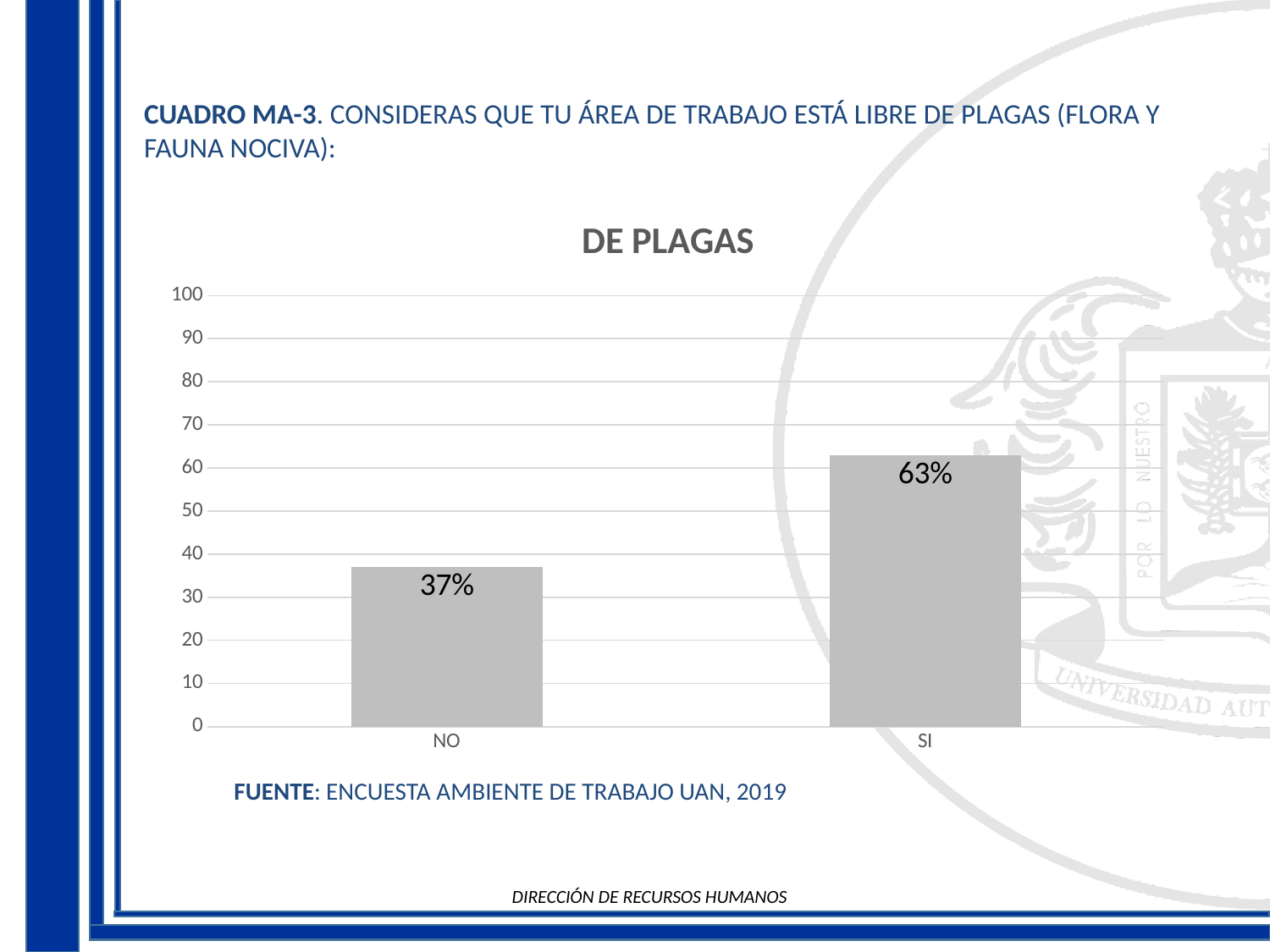
Is the value for NO greater or less than 40? less Which is larger, the value for NO or the value for SI? SI What is the difference between the values for SI and NO? 26% Which category has the lowest value? NO How many categories are shown on the x axis? 2 What is the title of the chart? DE PLAGAS What is the highest value shown on the y axis? 100 Which category has the highest value? SI What is the value for SI? 63% What is the value for NO? 37% Is the value for SI greater or less than 50? greater What kind of chart is shown on the slide? bar chart